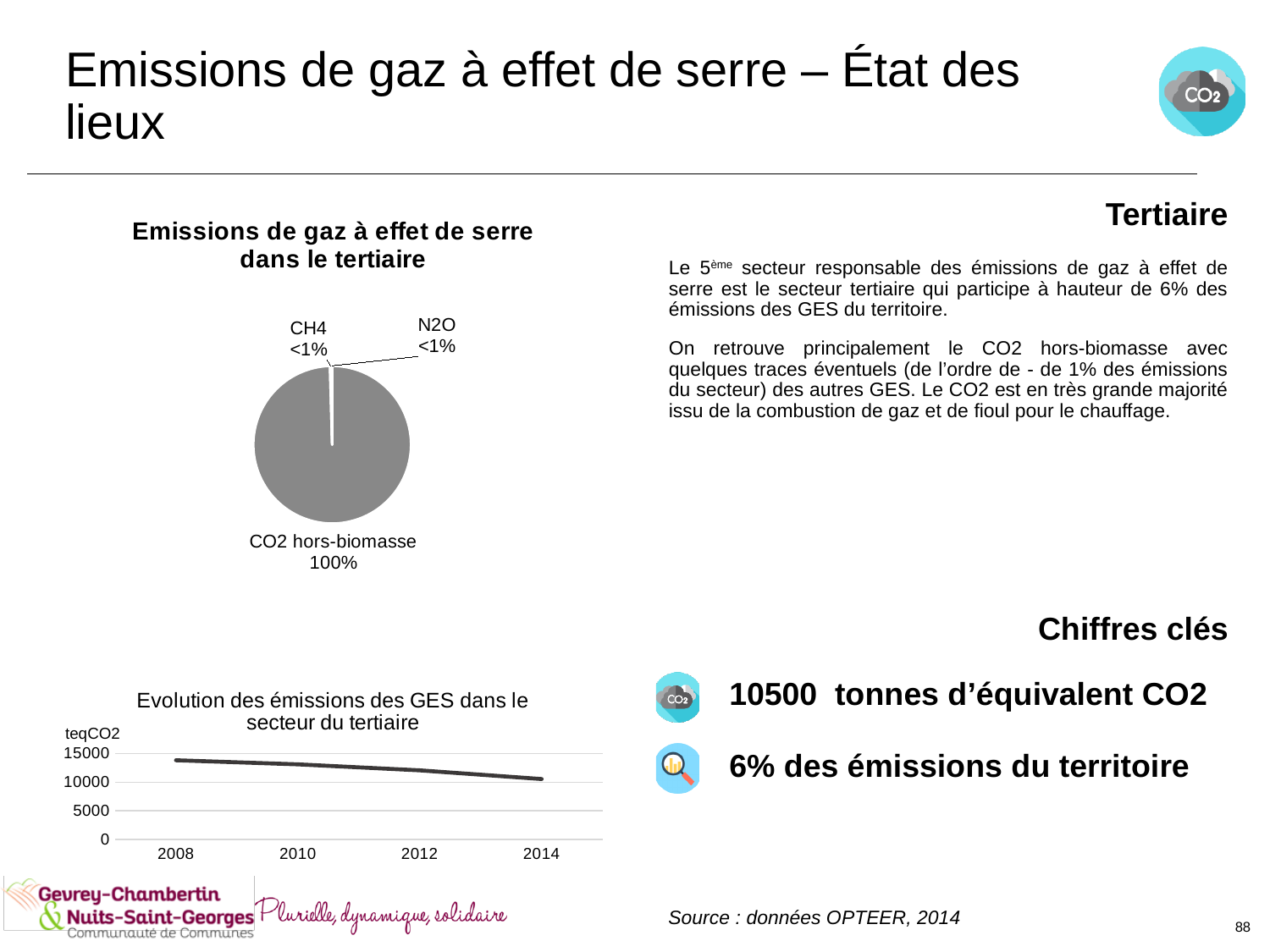
What kind of chart is the chart titled "Evolution des émissions des GES dans le secteur du tertiaire"? line chart How many categories are shown in the pie chart "Emissions de gaz à effet de serre dans le tertiaire"? 3 In the pie chart "Emissions de gaz à effet de serre dans le tertiaire", what share is shown for N2O? <1% What kind of chart is the chart titled "Emissions de gaz à effet de serre dans le tertiaire"? pie chart In the pie chart "Emissions de gaz à effet de serre dans le tertiaire", what share is shown for CO2 hors-biomasse? 100% In the pie chart "Emissions de gaz à effet de serre dans le tertiaire", what share is shown for CH4? <1% In the pie chart "Emissions de gaz à effet de serre dans le tertiaire", which category has the largest share? CO2 hors-biomasse In the chart "Evolution des émissions des GES dans le secteur du tertiaire", do the emissions rise or fall from 2008 to 2014? fall In the chart "Evolution des émissions des GES dans le secteur du tertiaire", which year has the higher value, 2008 or 2014? 2008 In the chart "Evolution des émissions des GES dans le secteur du tertiaire", is the value for 2014 greater or less than 15000? less In the chart "Evolution des émissions des GES dans le secteur du tertiaire", is the value for 2008 greater or less than 10000? greater What unit is shown on the y axis of the chart "Evolution des émissions des GES dans le secteur du tertiaire"? teqCO2